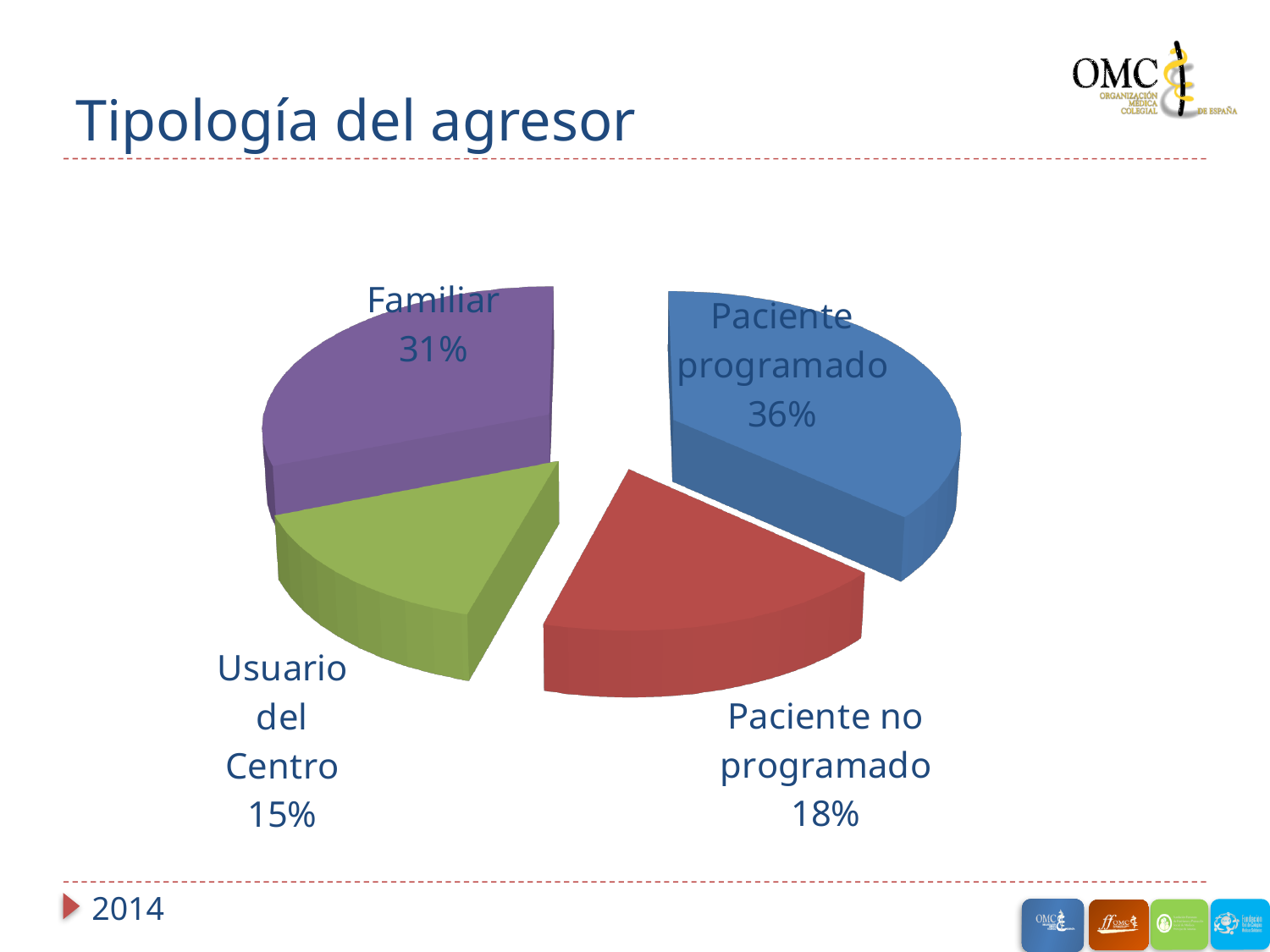
How many slices does the pie chart have? 4 What is the difference in percentage points between Paciente no programado and Usuario del Centro? 3 What percentage is shown for Paciente programado? 36% What kind of chart is shown on the slide? Pie chart What percentage is shown for Paciente no programado? 18% Which is larger, the share for Familiar or the share for Paciente no programado? Familiar Which category has the largest share of the pie? Paciente programado What is the title of the slide containing the chart? Tipología del agresor What percentage is shown for Usuario del Centro? 15% What is the difference in percentage points between Paciente programado and Familiar? 5 What percentage of the pie is labelled Familiar? 31% Which category has the smallest share of the pie? Usuario del Centro